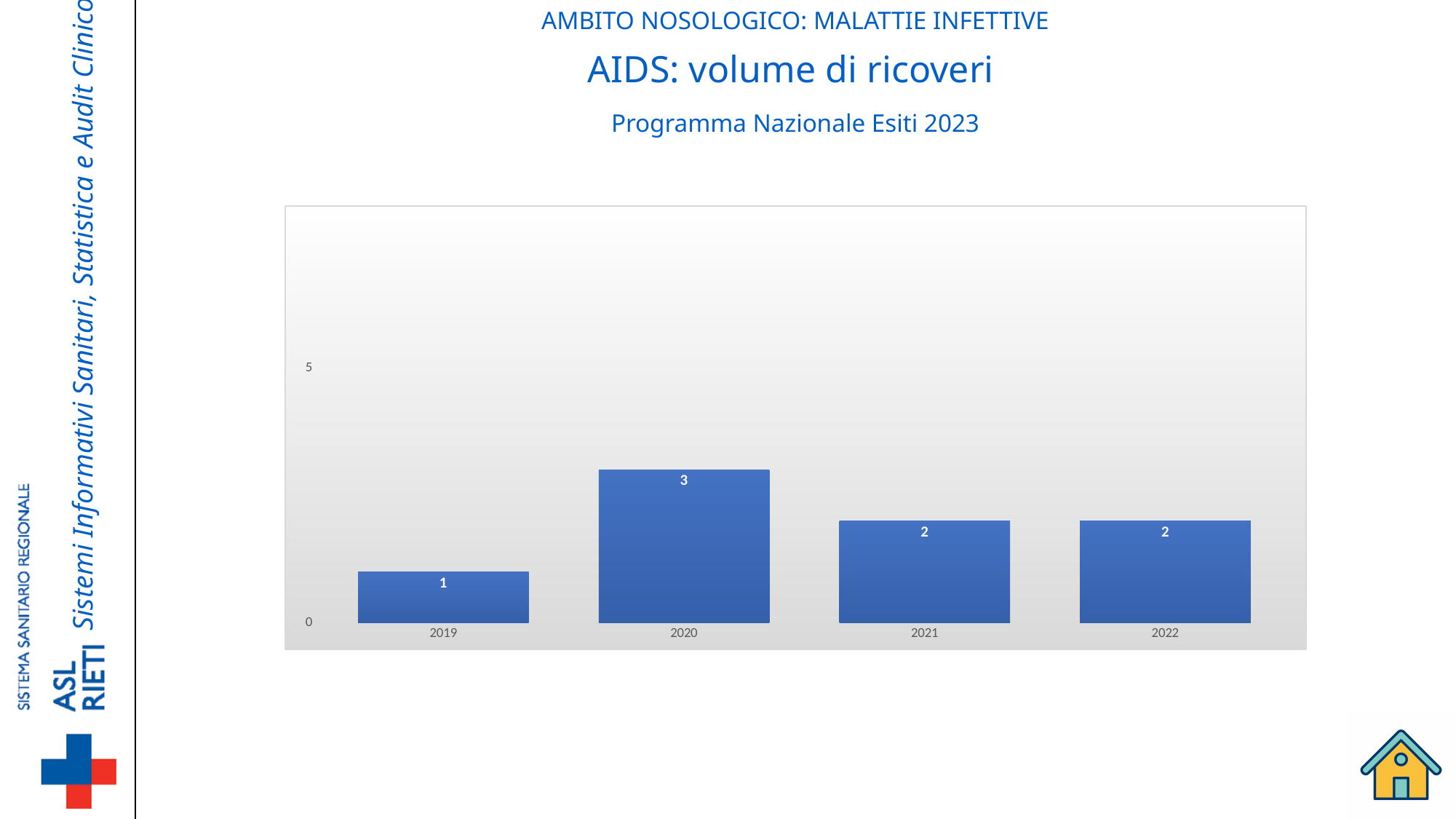
What is the value for 2022? 2 What kind of chart is shown on the slide? bar chart What is the title of the slide's chart section? AIDS: volume di ricoveri What is the difference between the values for 2020 and 2019? 2 Is the value for 2020 greater or less than 5? less How many years are shown on the x axis? 4 What is the value for 2019? 1 Which year has the lowest value? 2019 Which year has the highest value? 2020 What is the value for 2020? 3 Which is larger, the value for 2020 or the value for 2021? 2020 What is the value for 2021? 2